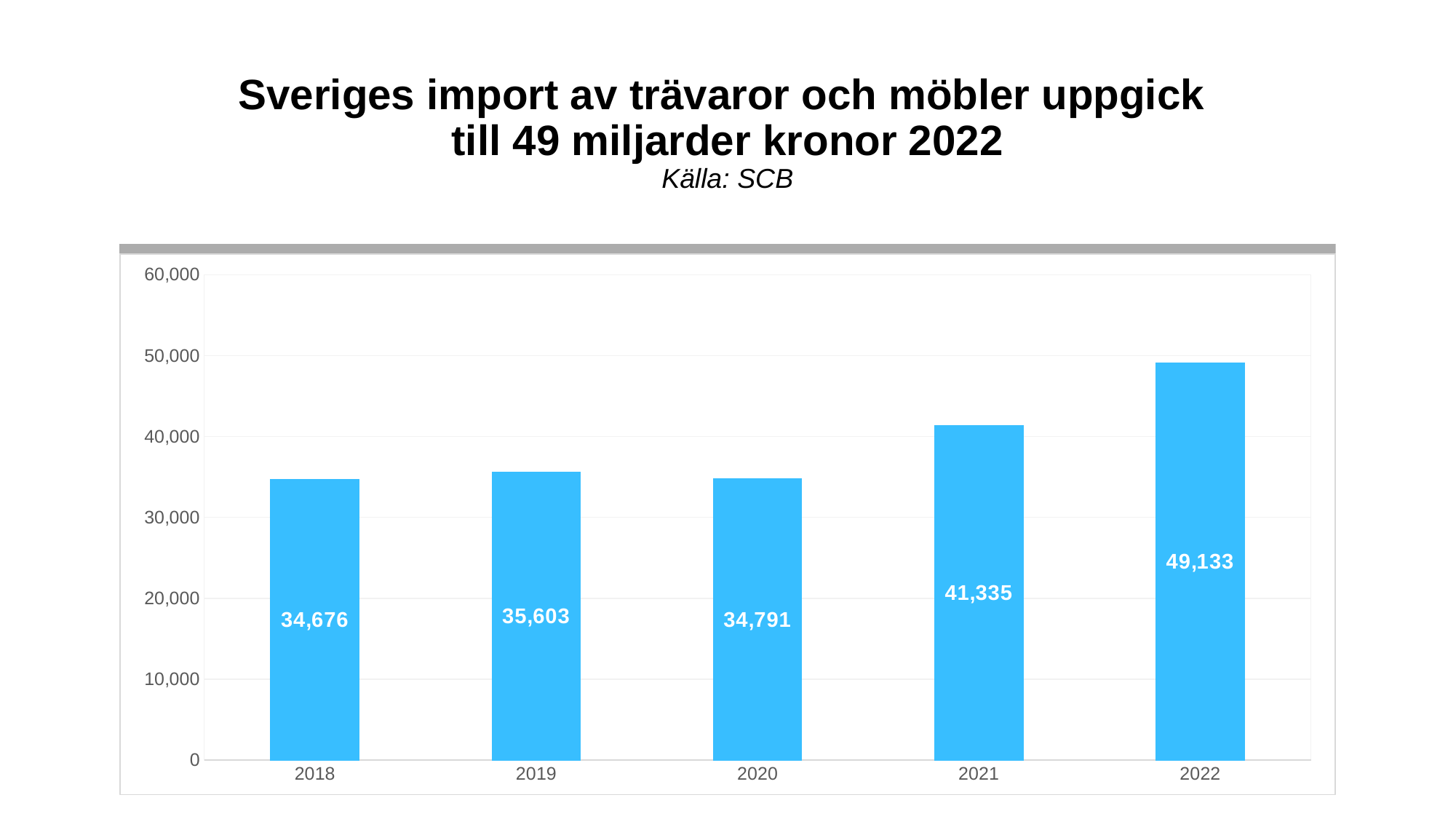
What kind of chart is shown on the slide? Bar chart What is the value for 2018? 34,676 What is the value for 2021? 41,335 Which is larger, the value for 2019 or the value for 2020? 2019 Which year has the lowest value? 2018 Is the value for 2021 greater or less than 40,000? greater Which year has the highest value? 2022 What source is cited below the chart title? SCB What is the difference between the values for 2019 and 2020? 812 What is the difference between the values for 2022 and 2021? 7,798 How many years are shown on the x axis? 5 What is the value for 2022? 49,133